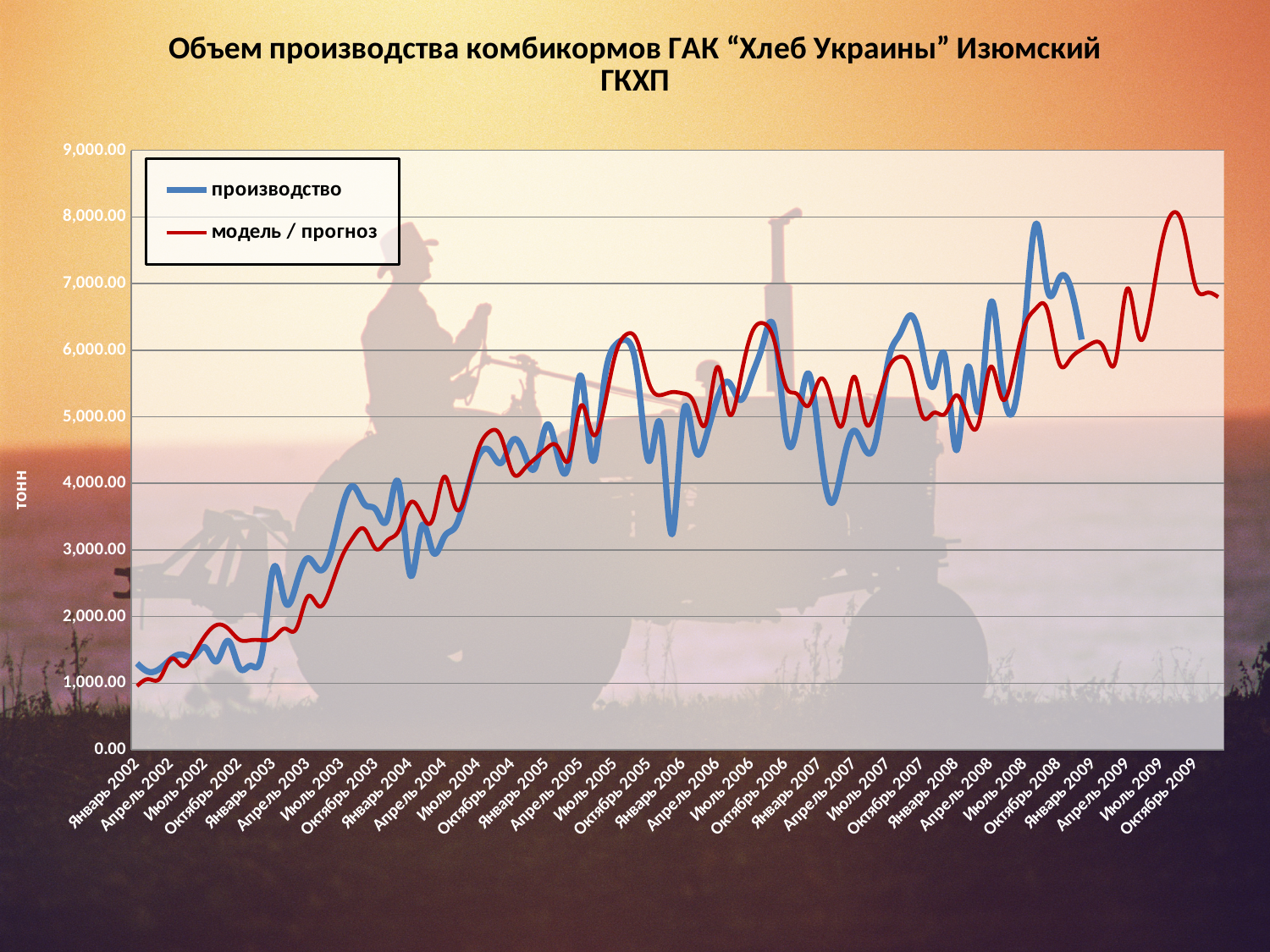
Is the value of производство in Январь 2006 greater or less than 4,000.00? greater What kind of chart is shown on the slide? line chart What are the two series named in the legend? производство and модель / прогноз Is the value of модель / прогноз in Октябрь 2009 greater or less than 6,000.00? greater Does the производство series generally rise or fall from Январь 2002 to Октябрь 2008? rise In Январь 2006, which series has the higher value, производство or модель / прогноз? модель / прогноз Is the value of производство in Январь 2002 greater or less than 2,000.00? less In Октябрь 2008, which series has the higher value, производство or модель / прогноз? производство How many series does the legend list? 2 What is the label on the vertical axis? тонн